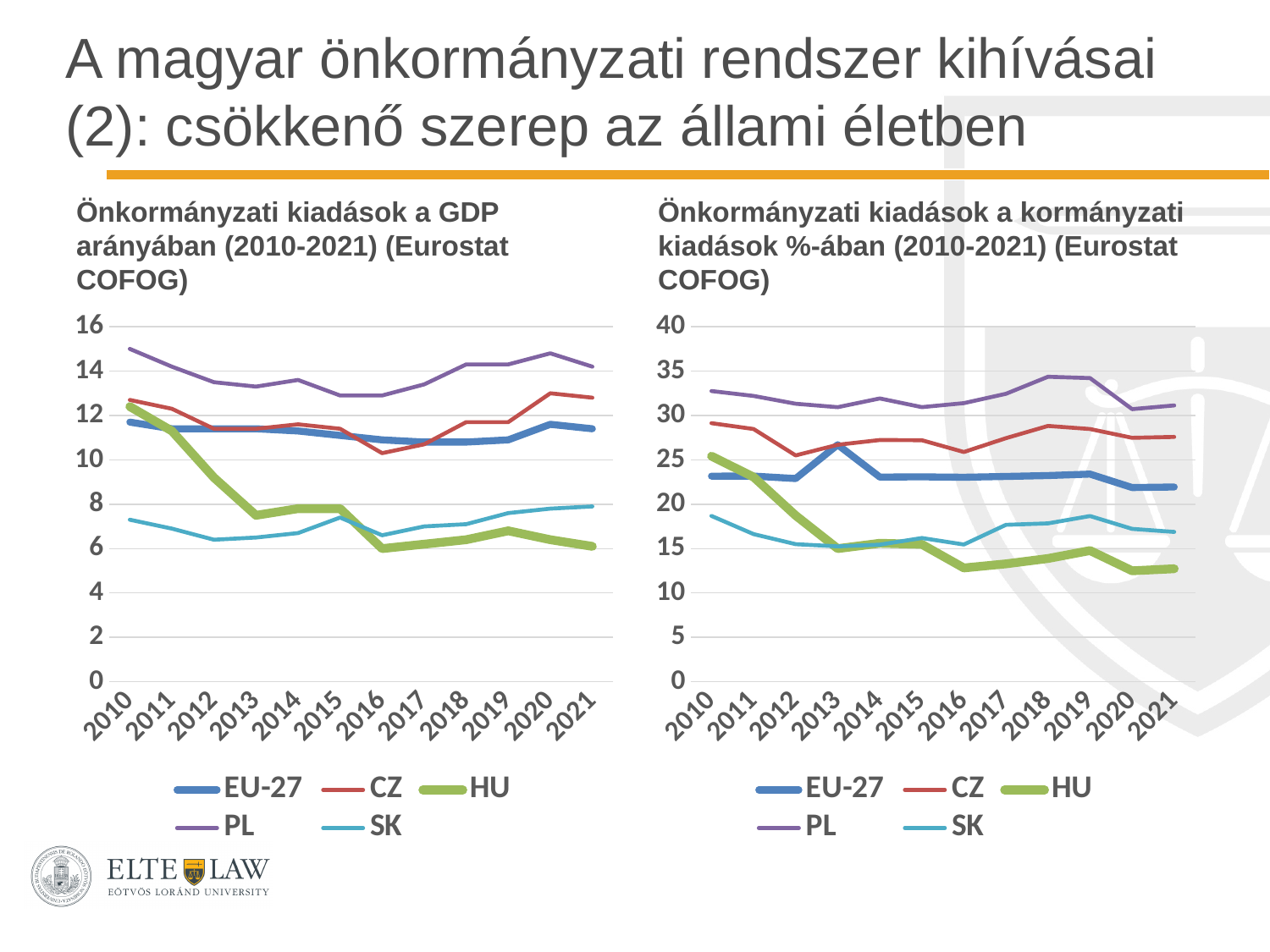
In the left chart, 'Önkormányzati kiadások a GDP arányában (2010-2021)', is the value for PL in 2010 greater or less than 14? greater In the left chart, 'Önkormányzati kiadások a GDP arányában (2010-2021)', which series has the highest value in 2021? PL How many years are shown on the x axis of the left chart, 'Önkormányzati kiadások a GDP arányában (2010-2021)'? 12 In the left chart, 'Önkormányzati kiadások a GDP arányában (2010-2021)', which series has the lowest value in 2021? HU In the left chart, 'Önkormányzati kiadások a GDP arányában (2010-2021)', is the value for HU in 2021 greater or less than 8? less In the right chart, 'Önkormányzati kiadások a kormányzati kiadások %-ában (2010-2021)', which is larger in 2021, SK or HU? SK In the right chart, 'Önkormányzati kiadások a kormányzati kiadások %-ában (2010-2021)', is the value for PL in 2018 greater or less than 30? greater What type of chart is the left chart, 'Önkormányzati kiadások a GDP arányában (2010-2021)'? Line chart In the left chart, 'Önkormányzati kiadások a GDP arányában (2010-2021)', does the HU series rise or fall from 2010 to 2021? Fall In the right chart, 'Önkormányzati kiadások a kormányzati kiadások %-ában (2010-2021)', which series has the lowest value in 2010? SK How many series does the legend of the right chart, 'Önkormányzati kiadások a kormányzati kiadások %-ában (2010-2021)', list? 5